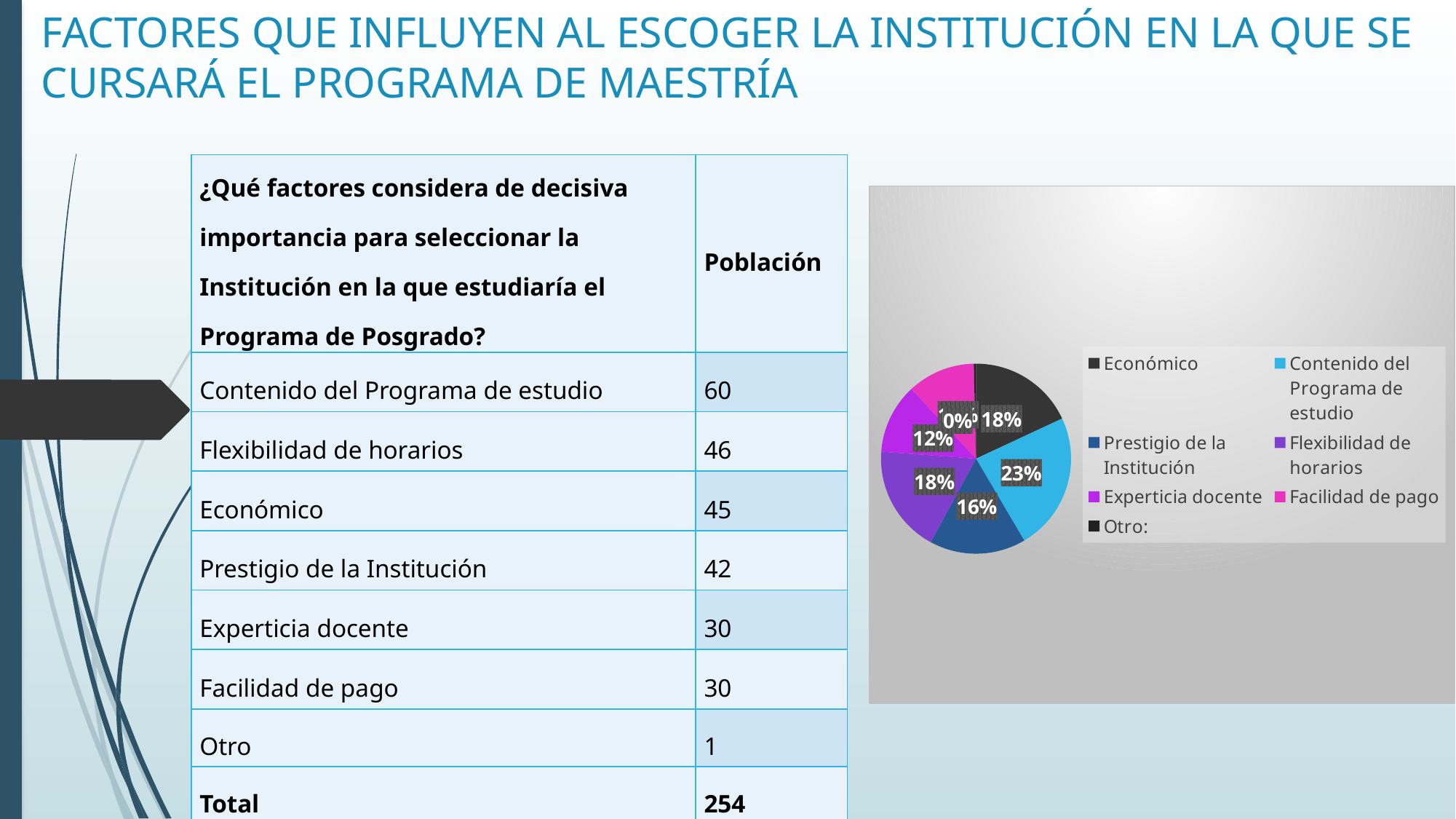
What colour is the Contenido del Programa de estudio slice in the pie chart? light blue Which legend entry is listed last in the pie chart legend? Otro: Which slice is larger, Económico or Experticia docente? Económico What is the difference in percentage points between Contenido del Programa de estudio and Prestigio de la Institución? 7 What share of the pie does Prestigio de la Institución have? 16% What share of the pie does Experticia docente have? 12% What kind of chart is shown on the slide? pie chart Which category has the largest slice of the pie? Contenido del Programa de estudio How many categories does the pie chart legend list? 7 What share of the pie does Flexibilidad de horarios have? 18% What share of the pie does Contenido del Programa de estudio have? 23% What share of the pie does Económico have? 18%